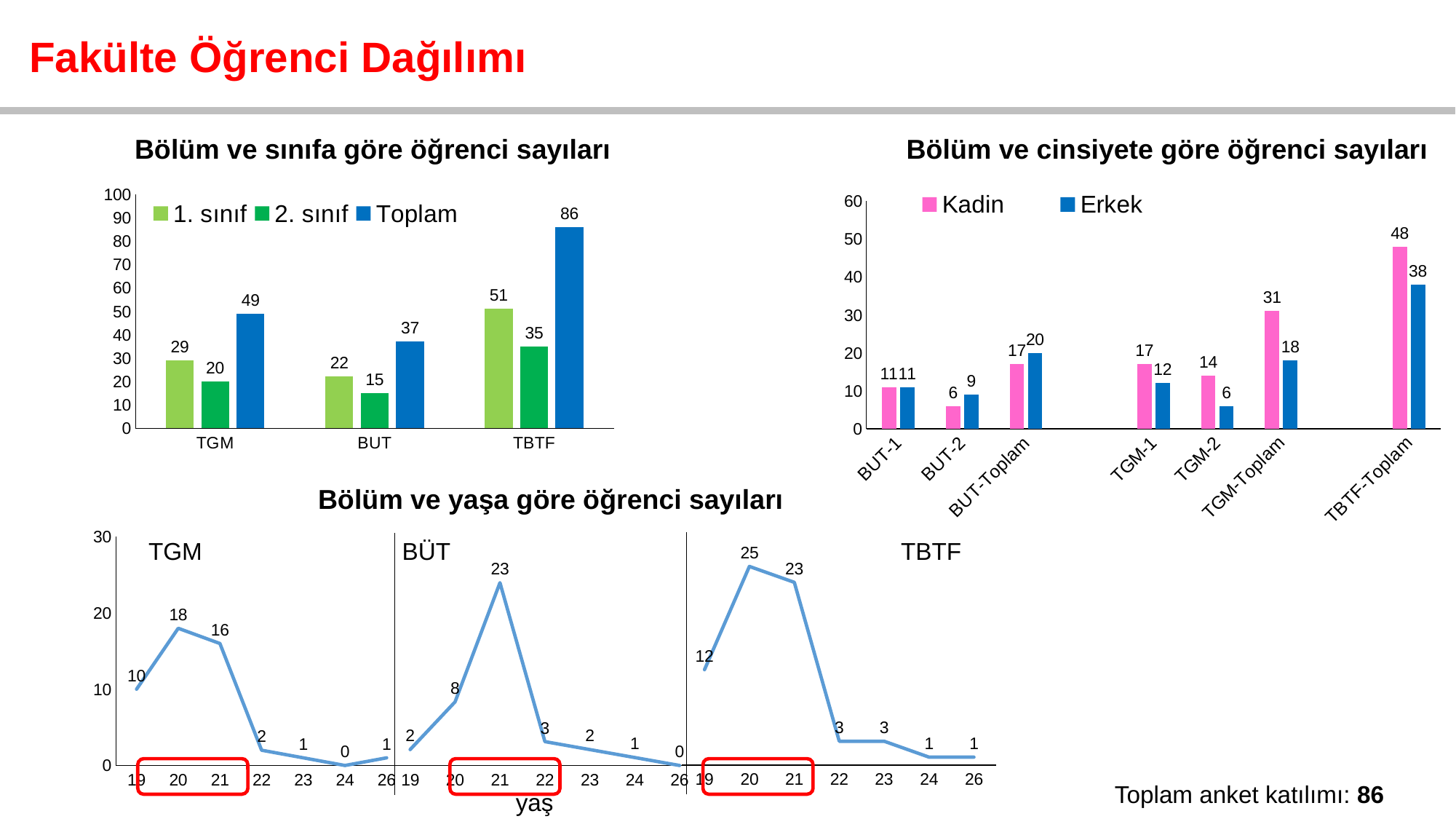
In the chart 'Bölüm ve cinsiyete göre öğrenci sayıları', how many categories are shown on the x axis? 7 In the chart 'Bölüm ve cinsiyete göre öğrenci sayıları', is the Kadin value for BUT-2 larger or smaller than the Erkek value for BUT-2? smaller In the chart 'Bölüm ve sınıfa göre öğrenci sayıları', how many series does the legend list? 3 In the chart 'Bölüm ve sınıfa göre öğrenci sayıları', which department has the lowest Toplam value? BUT In the chart 'Bölüm ve yaşa göre öğrenci sayıları', at which age does the TBTF panel reach its highest value? 20 In the chart 'Bölüm ve cinsiyete göre öğrenci sayıları', what is the Kadin value for TGM-Toplam? 31 What kind of chart is 'Bölüm ve yaşa göre öğrenci sayıları'? line chart In the chart 'Bölüm ve sınıfa göre öğrenci sayıları', what is the difference between the 1. sınıf and 2. sınıf values for TGM? 9 In the chart 'Bölüm ve yaşa göre öğrenci sayıları', what is the value for age 21 in the BÜT panel? 23 In the chart 'Bölüm ve cinsiyete göre öğrenci sayıları', which category has the highest Erkek value? TBTF-Toplam In the chart 'Bölüm ve yaşa göre öğrenci sayıları', do the TGM values rise or fall from age 21 to age 24? fall In the chart 'Bölüm ve sınıfa göre öğrenci sayıları', what is the Toplam value for TBTF? 86